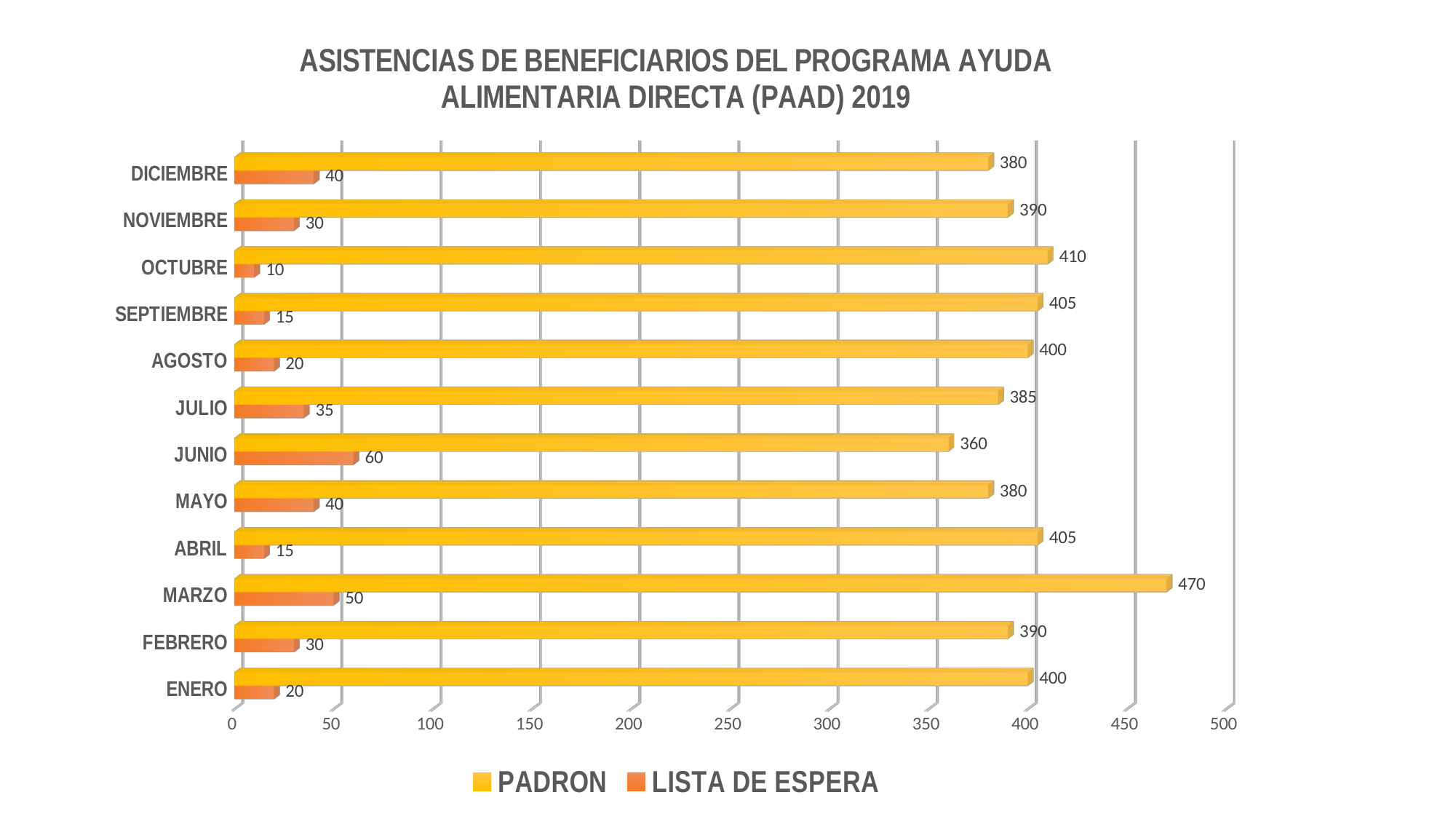
Which month has the lowest PADRON value? JUNIO What kind of chart is shown on the slide? Bar chart How many months are shown on the chart? 12 What is the PADRON value for OCTUBRE? 410 Which is larger, the LISTA DE ESPERA value for DICIEMBRE or for NOVIEMBRE? DICIEMBRE What is the LISTA DE ESPERA value for JUNIO? 60 Which month has the highest PADRON value? MARZO Which month has the lowest LISTA DE ESPERA value? OCTUBRE How many series does the legend list? 2 What is the total of the PADRON and LISTA DE ESPERA values for ENERO? 420 What is the PADRON value for MARZO? 470 What is the difference between the PADRON values for MARZO and JUNIO? 110